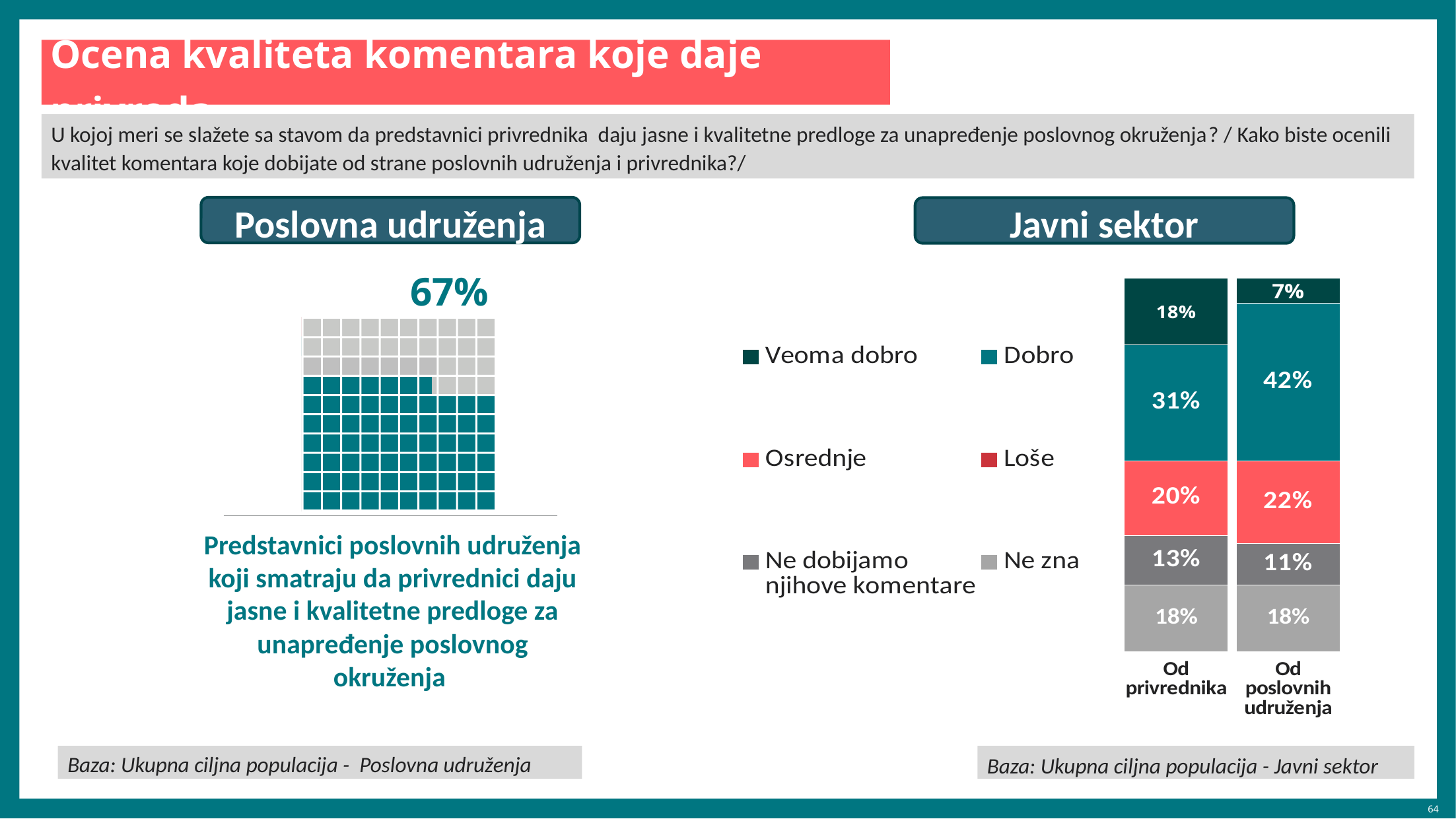
In the Javni sektor chart, what is the difference between the Dobro values for Od poslovnih udruženja and Od privrednika? 11% In the Poslovna udruženja chart, what percentage of representatives consider that businesses give clear and quality proposals? 67% What kind of chart is the Javni sektor chart? Stacked bar chart In the Javni sektor chart, what is the Dobro value for Od privrednika? 31% In the Javni sektor chart, what is the Osrednje value for Od poslovnih udruženja? 22% In the Javni sektor chart, how many bars are shown? 2 In the Javni sektor chart, what is the Ne dobijamo njihove komentare value for Od privrednika? 13% In the Javni sektor chart, which segment is the smallest in the Od poslovnih udruženja bar? Veoma dobro In the Javni sektor chart, what is the Veoma dobro value for Od poslovnih udruženja? 7% In the Javni sektor chart, which segment is the largest in the Od poslovnih udruženja bar? Dobro In the Javni sektor chart, how many entries does the legend list? 6 In the Javni sektor chart, which has the larger Veoma dobro value, Od privrednika or Od poslovnih udruženja? Od privrednika